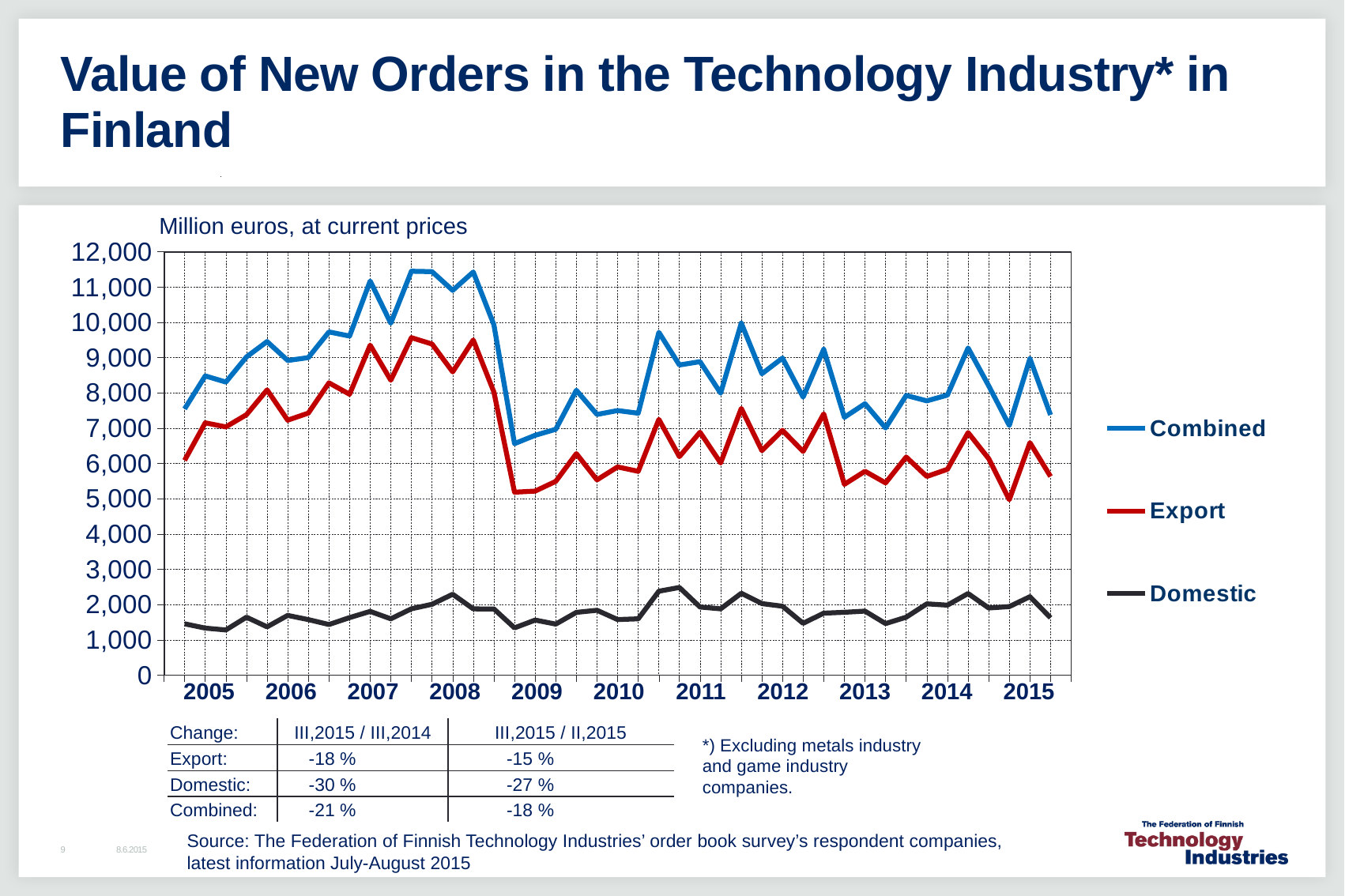
What kind of chart is shown on the slide? line chart Which series has the lowest values throughout the chart? Domestic Is the peak value of the Combined series in 2007–2008 greater or less than 11,000? greater What unit is stated above the chart's y axis? Million euros, at current prices Is the lowest value of the Export series in 2009 greater or less than 6,000? less How many year labels appear along the x axis? 11 What are the three series named in the legend? Combined, Export, Domestic Is the Domestic series ever greater or less than 3,000 over the whole period? less Does the Combined series rise or fall between 2008 and early 2009? fall Which series has the highest values throughout the chart? Combined How many series does the legend list? 3 Which is larger in 2011, the Export series or the Domestic series? Export